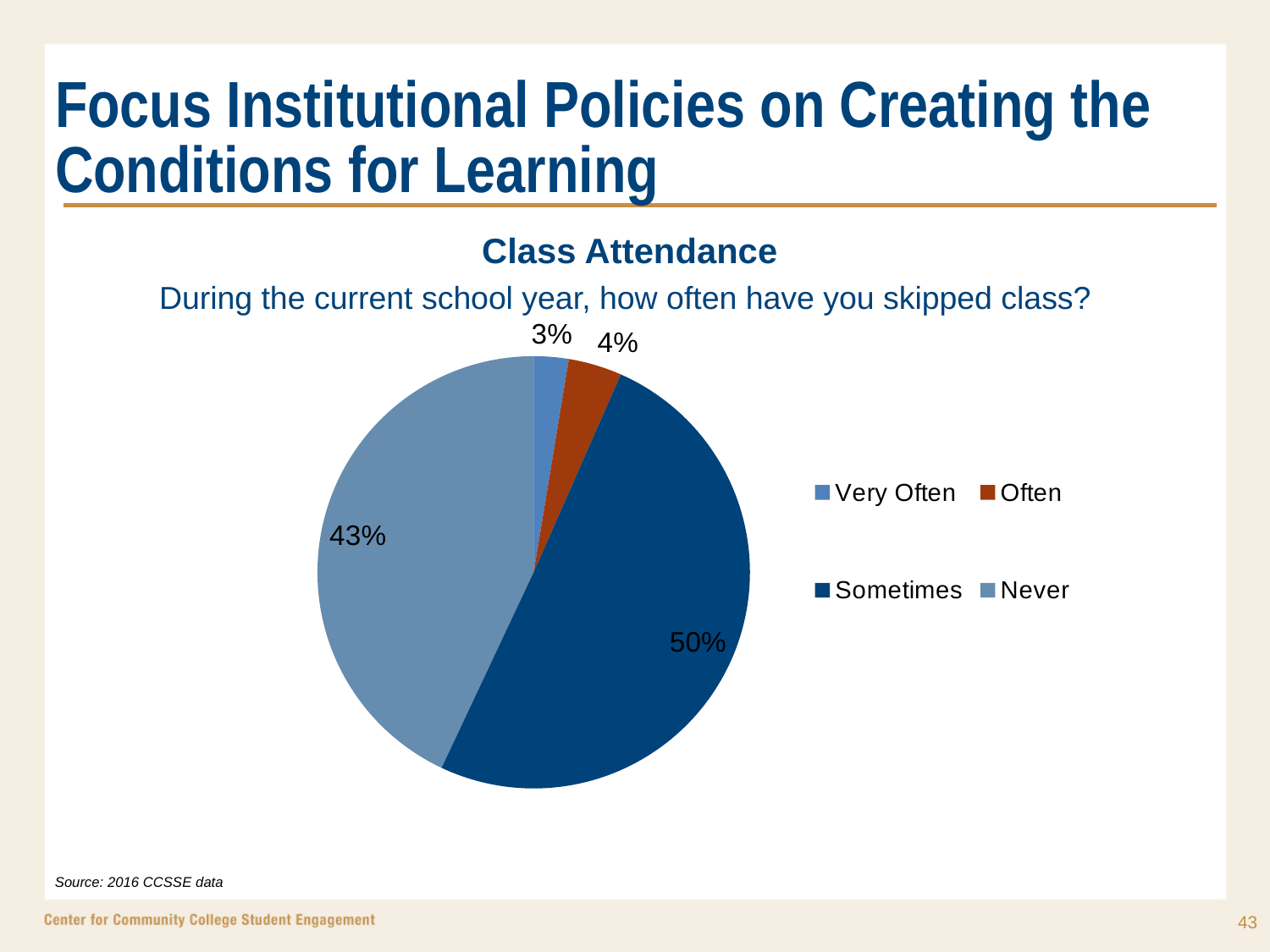
What colour is the "Often" slice of the pie? orange-brown What percentage of students said they skipped class "Often"? 4% Which response category has the largest share of the pie? Sometimes What percentage of students said they skipped class "Very Often"? 3% What is the difference in percentage points between "Sometimes" and "Never"? 7 What percentage of students said they skipped class "Sometimes"? 50% How many response categories does the legend list? 4 What percentage of students said they "Never" skipped class? 43% Which response category has the smallest share of the pie? Very Often What kind of chart is shown on the slide? pie chart Which is larger, the share for "Often" or the share for "Very Often"? Often What is the title of the chart? Class Attendance